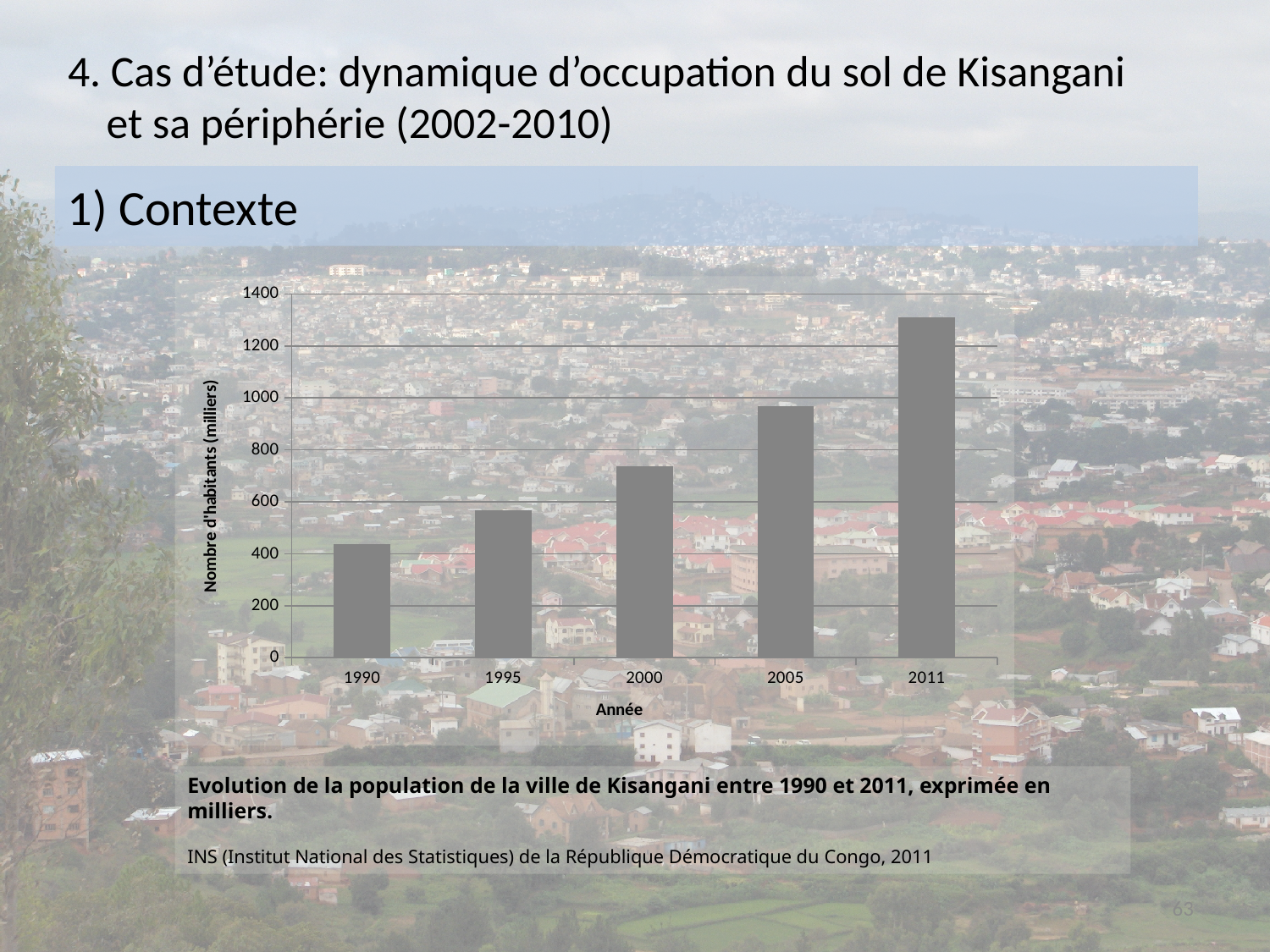
Which year has a larger value, 1995 or 2005? 2005 Is the value for 2011 greater or less than 1200? greater How many years are plotted on the x axis of the chart? 5 Which year has the lowest number of inhabitants in the chart? 1990 Which year has the highest number of inhabitants in the chart? 2011 What is the label of the x axis of the chart? Année Is the value for 2000 greater or less than 800? less What is the label of the y axis of the chart? Nombre d'habitants (milliers) Do the values rise or fall from 1990 to 2011 along the x axis? rise Is the value for 2005 greater or less than 800? greater What kind of chart is shown on the slide? bar chart